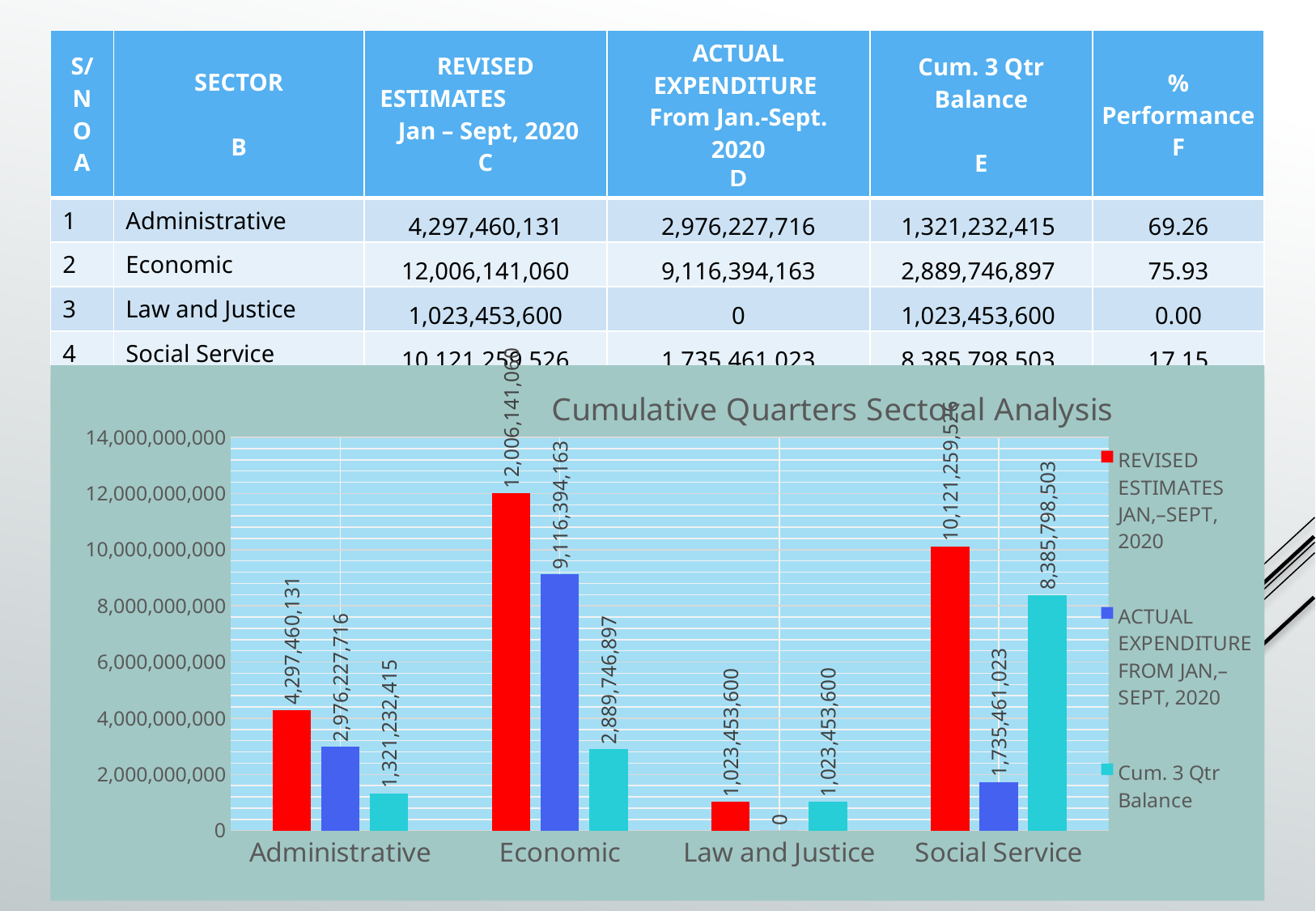
Which sector has the lowest Cum. 3 Qtr Balance value in the chart? Law and Justice What type of chart is shown on the slide? Bar chart What is the Revised Estimates value for the Economic sector in the chart? 12,006,141,060 How many series does the chart legend list? 3 Which is larger in the chart: the Actual Expenditure for Economic or the Actual Expenditure for Social Service? Economic What is the difference between the Revised Estimates and Actual Expenditure for the Administrative sector in the chart? 1,321,232,415 How many sector categories are shown on the x axis of the chart? 4 Which sector has the highest Revised Estimates value in the chart? Economic What is the Actual Expenditure value for Law and Justice in the chart? 0 Is the Revised Estimates value for Social Service greater or less than 8,000,000,000 in the chart? greater What is the Cum. 3 Qtr Balance value for Social Service in the chart? 8,385,798,503 What is the title of the chart? Cumulative Quarters Sectoral Analysis